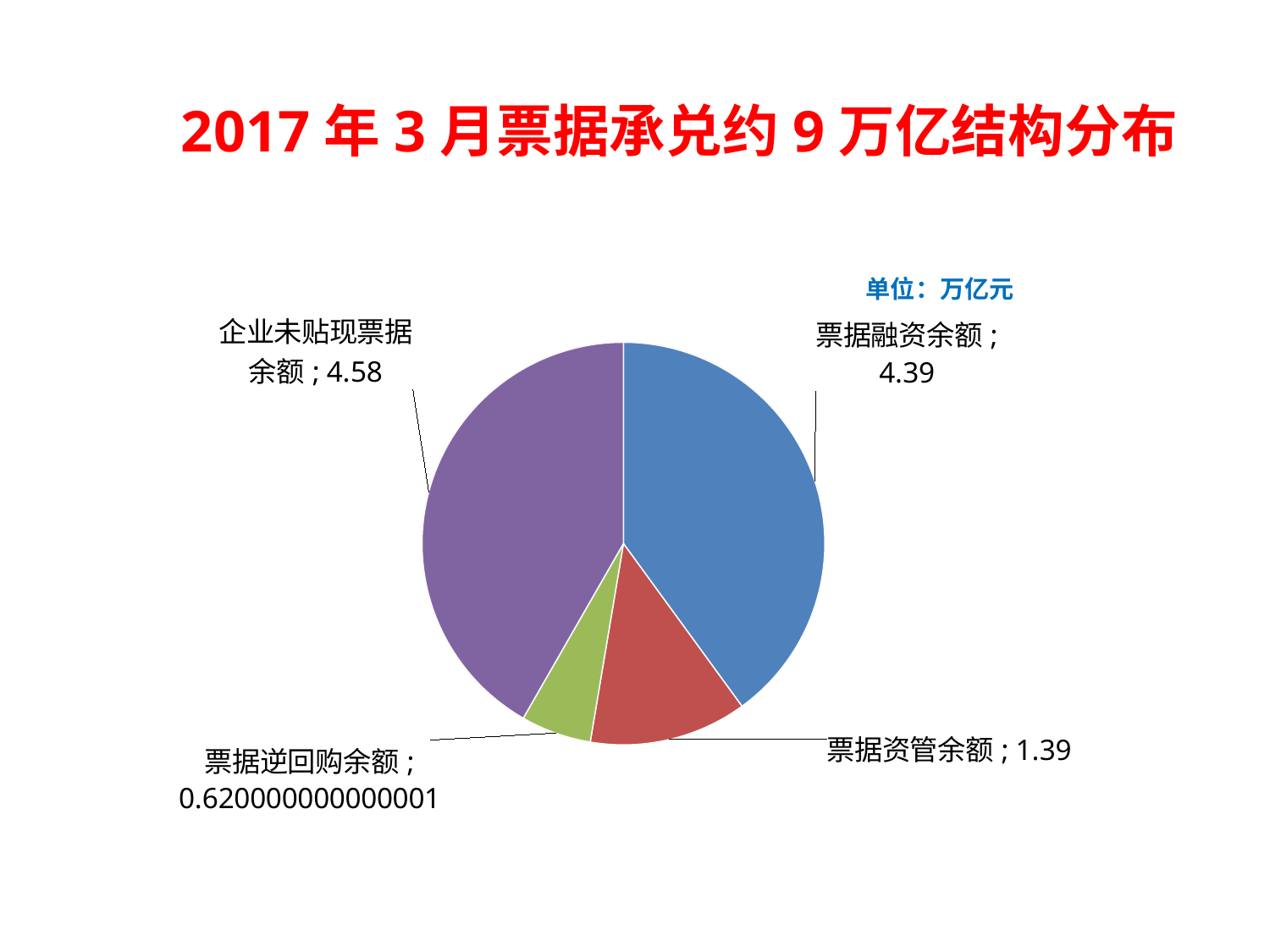
What value is printed for 票据逆回购余额? 0.620000000000001 What is the difference between the values for 企业未贴现票据余额 and 票据融资余额? 0.19 What is the title of the slide? 2017年3月票据承兑约9万亿结构分布 What kind of chart is shown on the slide? pie chart Which category has the smallest slice of the pie? 票据逆回购余额 What is the value shown for 企业未贴现票据余额? 4.58 How many slices does the pie chart have? 4 Which is larger, 票据融资余额 or 票据资管余额? 票据融资余额 What unit is stated for the values in the chart? 万亿元 Which category has the largest slice of the pie? 企业未贴现票据余额 What is the value shown for 票据融资余额? 4.39 What is the value shown for 票据资管余额? 1.39